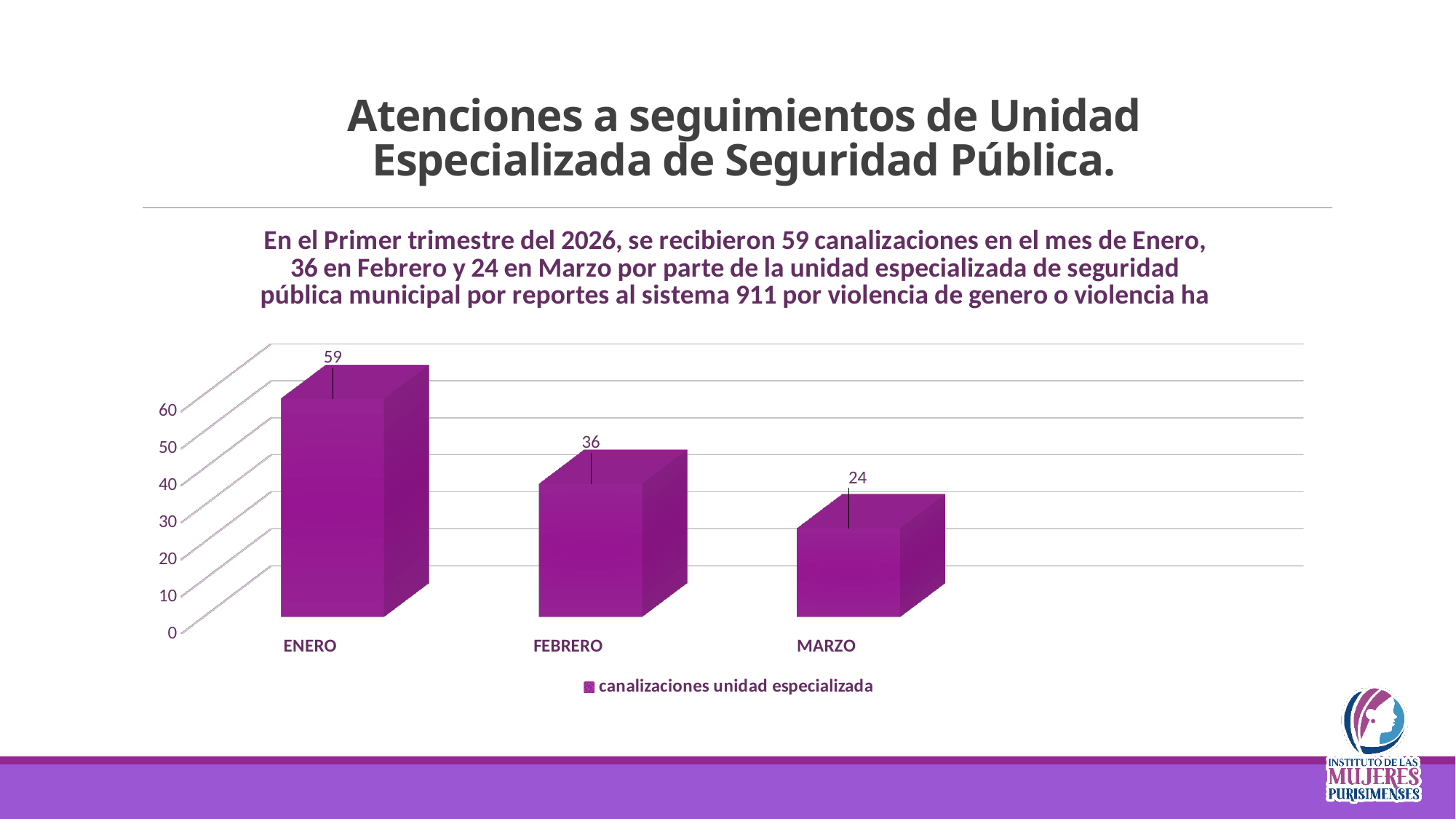
Which month has the highest value? ENERO Which is larger, the value for FEBRERO or the value for MARZO? FEBRERO What is the difference between the values for FEBRERO and MARZO? 12 How many series does the legend list? 1 What kind of chart is shown on the slide? bar chart What is the value for FEBRERO? 36 How many months are shown on the x axis? 3 What is the value for ENERO? 59 What is the value for MARZO? 24 Which month has the lowest value? MARZO Do the values rise or fall from ENERO to MARZO? fall What is the difference between the values for ENERO and FEBRERO? 23